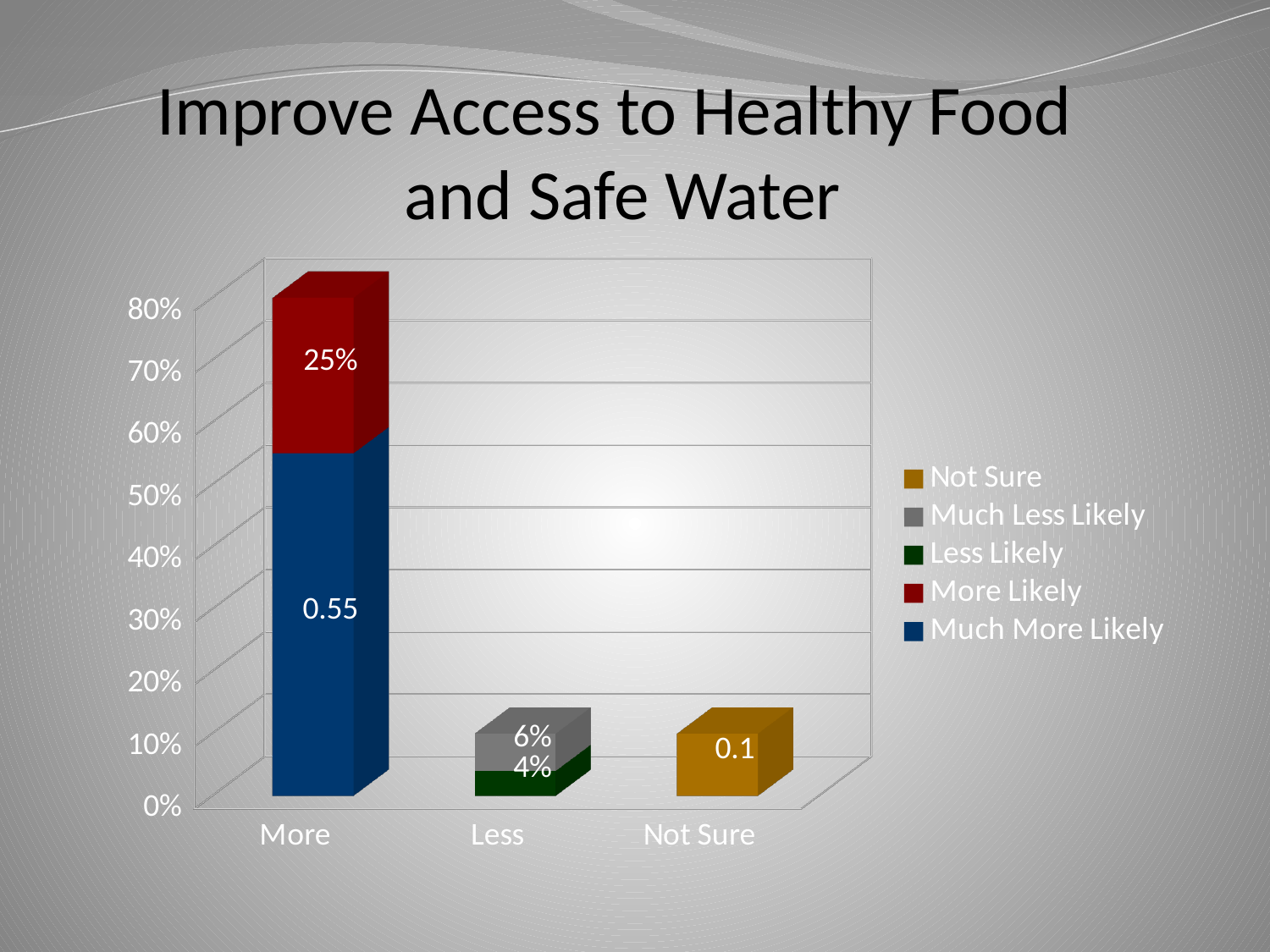
Is the total height of the More bar greater or less than 70%? greater What kind of chart is shown on the slide? Stacked bar chart What is the data label on the Much More Likely segment of the More bar? 0.55 How many series does the legend list? 5 What is the value of the Less Likely segment in the Less bar? 4% What is the value of the More Likely segment in the More bar? 25% Which category has the tallest bar? More What is the value of the Much Less Likely segment in the Less bar? 6% What is the total of the stacked Less bar? 10% What is the difference between the Much Less Likely and Less Likely values in the Less bar? 2% What is the data label on the Not Sure bar? 0.1 How many categories are shown on the x axis? 3